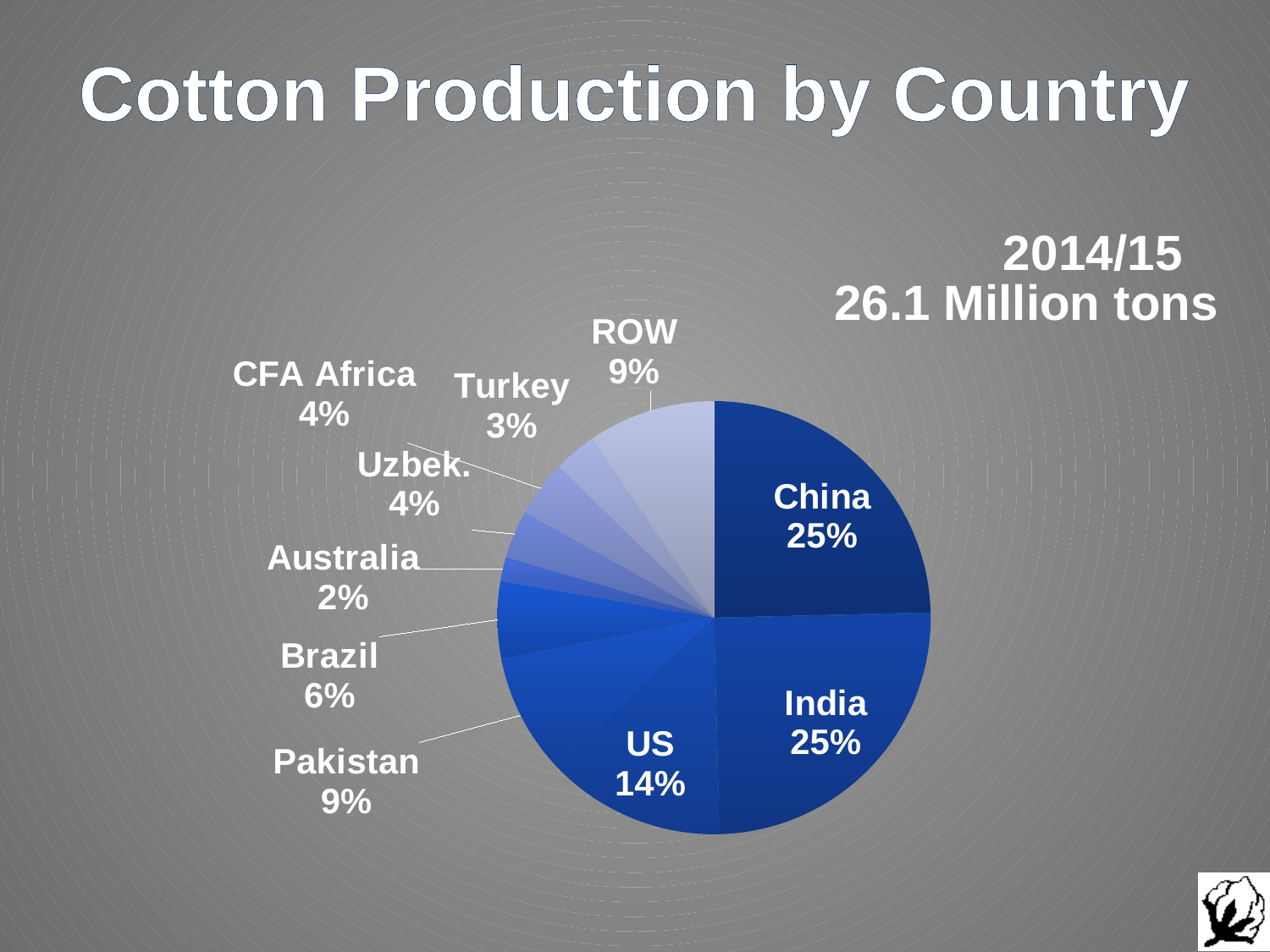
What is the value shown for Turkey? 3% Which is larger, the share for the US or the share for Pakistan? US What percentage of cotton production is attributed to Pakistan? 9% How many percentage points larger is China's share than the US share? 11% What share is shown for Brazil? 6% What is the value shown for the US slice? 14% What total production figure is shown for 2014/15? 26.1 Million tons Which country has the smallest slice of the pie? Australia How many slices does the pie chart have? 10 What kind of chart is shown on the slide? pie chart What share of cotton production does China account for? 25% What is the title of the chart on the slide? Cotton Production by Country